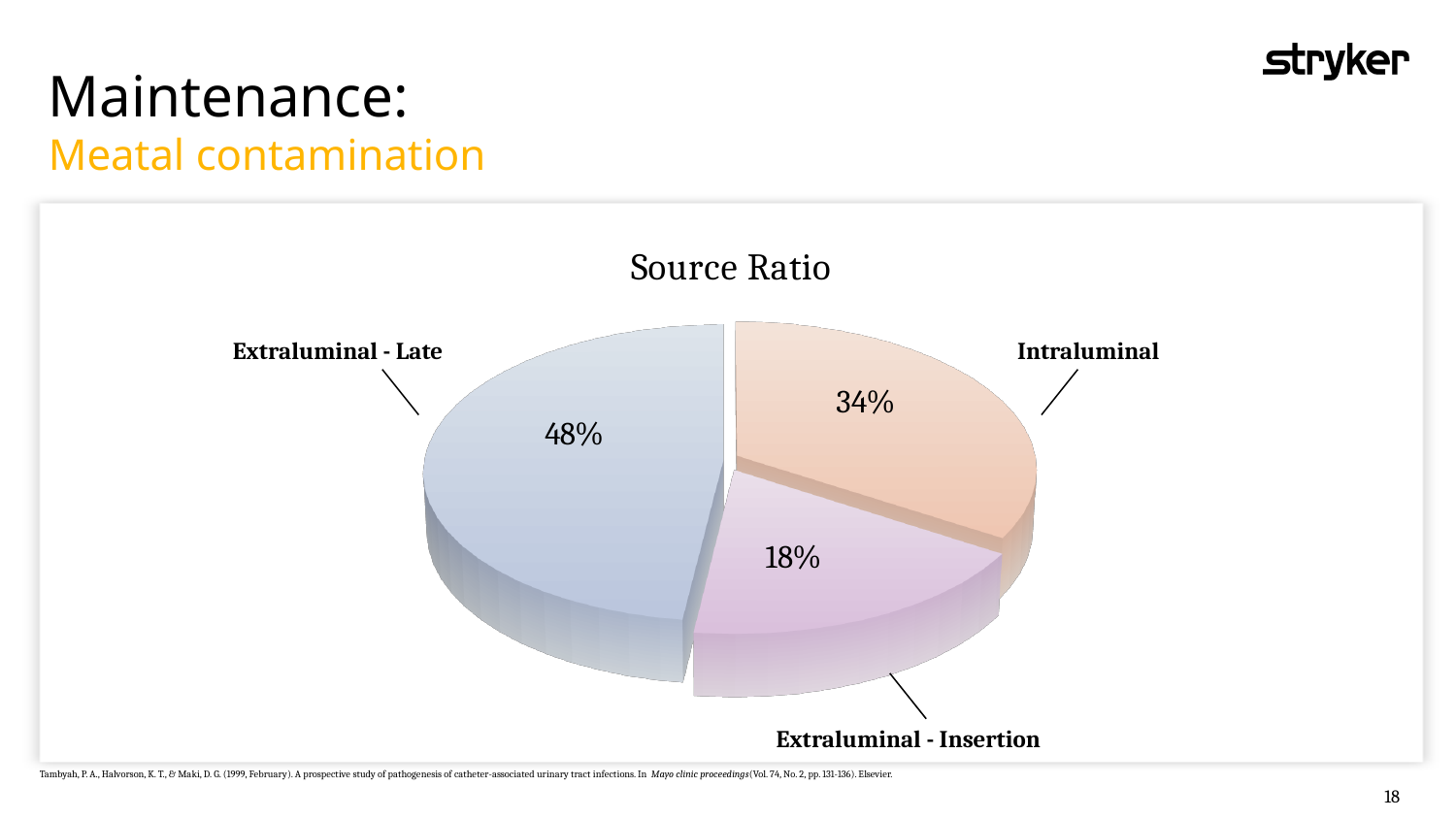
Which category has the largest slice of the pie? Extraluminal - Late How many slices does the pie chart have? 3 What is the title of the chart? Source Ratio What is the combined share of the two Extraluminal slices? 66% What share of the pie does Extraluminal - Insertion represent? 18% What is the difference in percentage points between Extraluminal - Late and Intraluminal? 14 Which is larger, the Intraluminal slice or the Extraluminal - Insertion slice? Intraluminal Which category has the smallest slice of the pie? Extraluminal - Insertion What share of the pie does Extraluminal - Late represent? 48% What is the difference in percentage points between Intraluminal and Extraluminal - Insertion? 16 What type of chart is shown on the slide? Pie chart What share of the pie does Intraluminal represent? 34%